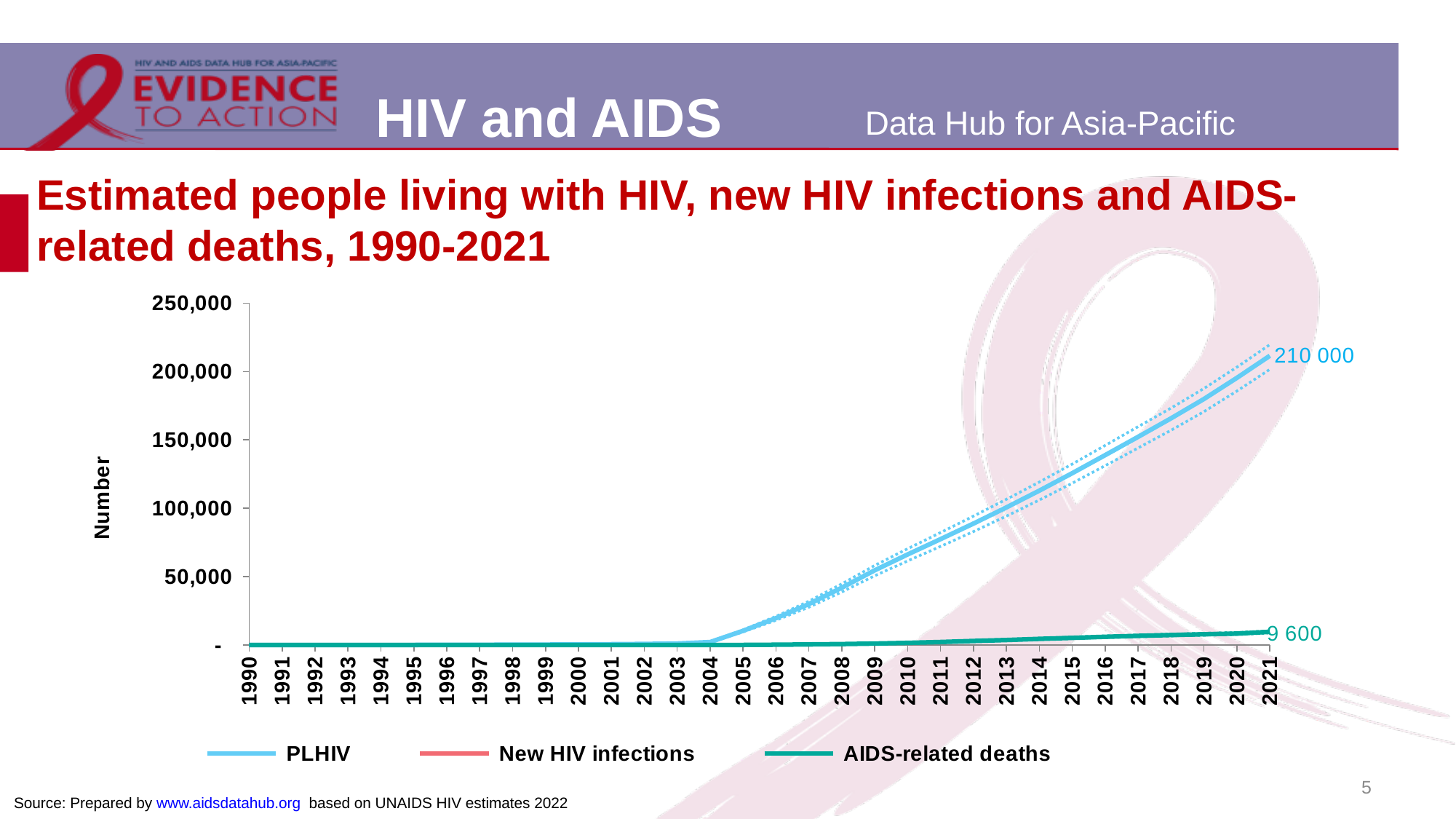
What kind of chart is shown on the slide? Line chart How many series does the legend list? 3 Does the PLHIV line rise or fall from 2004 to 2021? Rises Is the PLHIV value for 2020 greater or less than 150,000? greater In which year does the PLHIV line reach its highest value? 2021 What is the label on the vertical axis of the chart? Number What is the estimated number of AIDS-related deaths in 2021? 9 600 What is the estimated number of people living with HIV (PLHIV) in 2021? 210 000 In 2021, which is larger: PLHIV or AIDS-related deaths? PLHIV What is the difference between the PLHIV value and the AIDS-related deaths value in 2021? 200 400 Is the PLHIV value for 2006 greater or less than 50,000? less Is the PLHIV value for 2015 greater or less than 100,000? greater